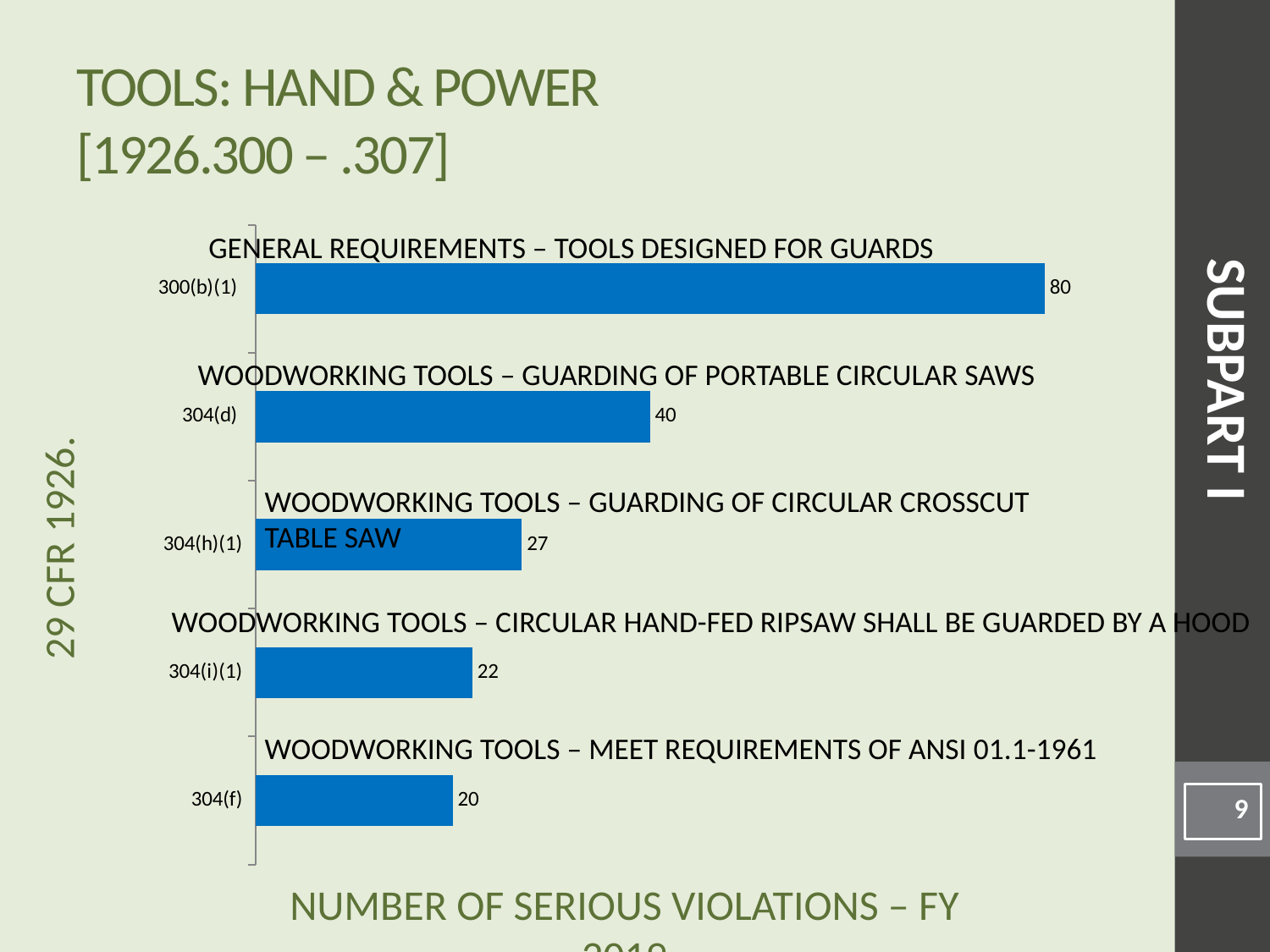
How many categories are shown in the chart? 5 What is the number of serious violations for 304(i)(1)? 22 Which category has the lowest number of serious violations? 304(f) What is the number of serious violations for 304(f)? 20 Which has a larger value, 304(h)(1) or 304(i)(1)? 304(h)(1) What is the number of serious violations for 300(b)(1)? 80 What is the number of serious violations for 304(d)? 40 What kind of chart is shown on the slide? Bar chart What is the difference between the values for 304(i)(1) and 304(f)? 2 What is the number of serious violations for 304(h)(1)? 27 What is the difference between the values for 300(b)(1) and 304(d)? 40 Which category has the highest number of serious violations? 300(b)(1)